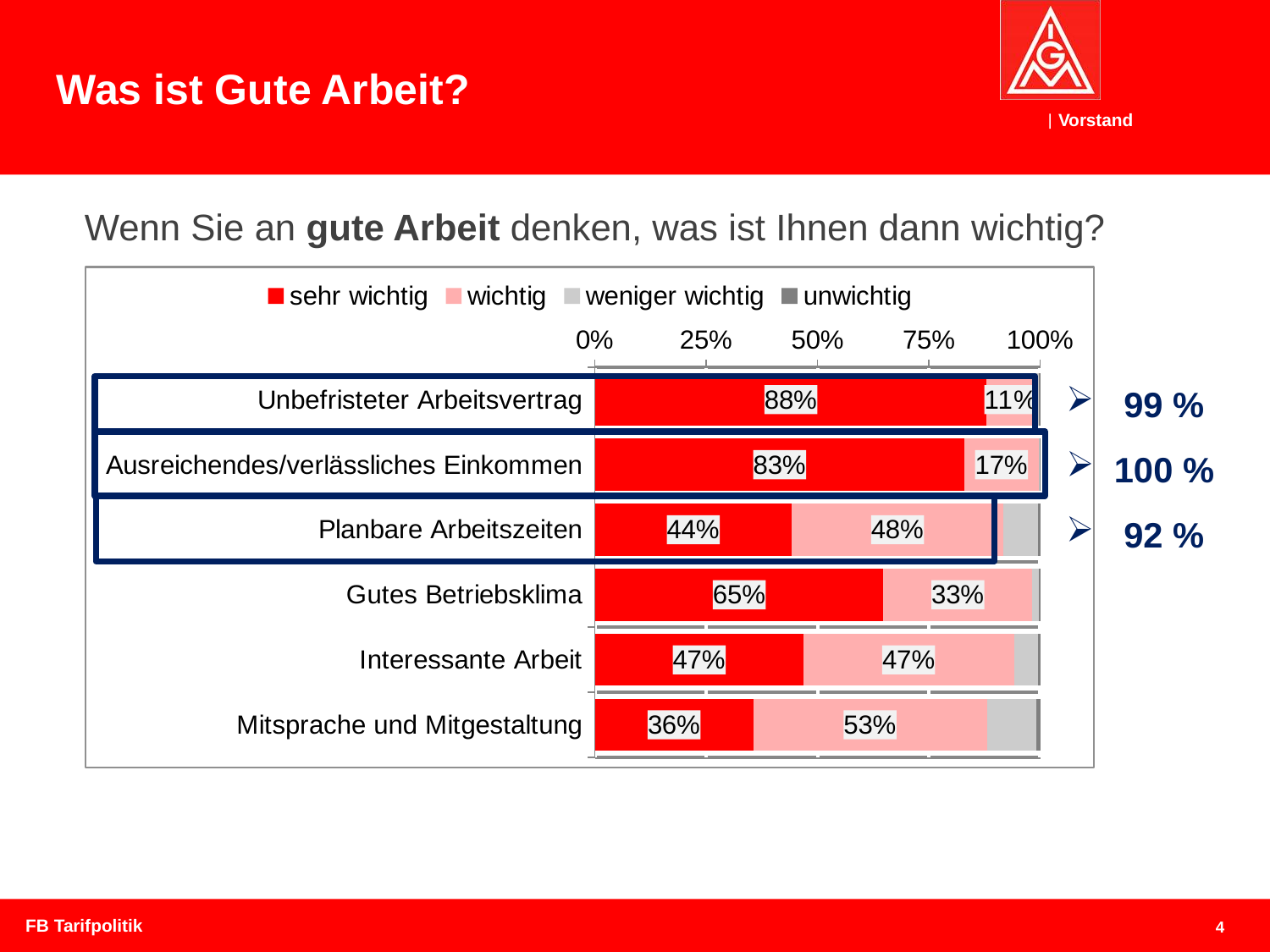
What is the 'sehr wichtig' value for Unbefristeter Arbeitsvertrag? 88% Which category has the lowest 'sehr wichtig' value? Mitsprache und Mitgestaltung What is the 'wichtig' value for Mitsprache und Mitgestaltung? 53% How many series does the legend list? 4 Which category has the highest 'sehr wichtig' value? Unbefristeter Arbeitsvertrag What kind of chart is shown on the slide? Stacked bar chart What is the difference between the 'sehr wichtig' values for Unbefristeter Arbeitsvertrag and Ausreichendes/verlässliches Einkommen? 5 percentage points What is the 'wichtig' value for Ausreichendes/verlässliches Einkommen? 17% Is the 'sehr wichtig' value for Interessante Arbeit greater or less than 50%? less What combined percentage is printed to the right of the chart for Planbare Arbeitszeiten? 92 % Which has the larger 'sehr wichtig' value: Gutes Betriebsklima or Planbare Arbeitszeiten? Gutes Betriebsklima How many categories (rows) does the chart show? 6